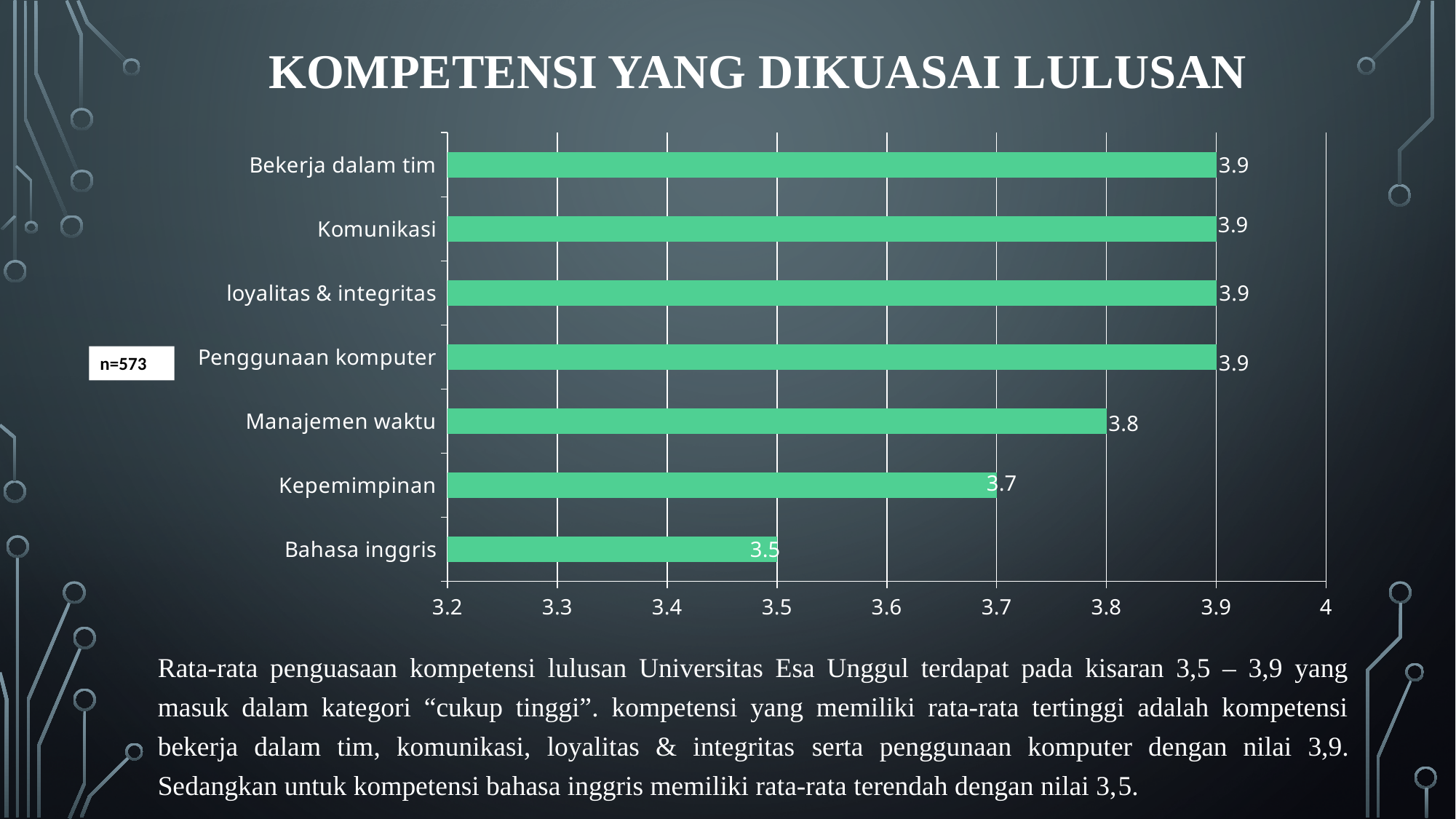
Which is larger, the value for Kepemimpinan or the value for Bahasa inggris? Kepemimpinan Is the value for Kepemimpinan greater or less than 3.6? greater What is the value for Manajemen waktu? 3.8 What is the value for Komunikasi? 3.9 What is the title of the slide containing the chart? KOMPETENSI YANG DIKUASAI LULUSAN What is the difference between the values for Manajemen waktu and Bahasa inggris? 0.3 What is the value for Kepemimpinan? 3.7 How many categories are shown in the chart? 7 Which category has the lowest value? Bahasa inggris What is the difference between the values for Bekerja dalam tim and Kepemimpinan? 0.2 What kind of chart is shown on the slide? bar chart What is the value for Bahasa inggris? 3.5